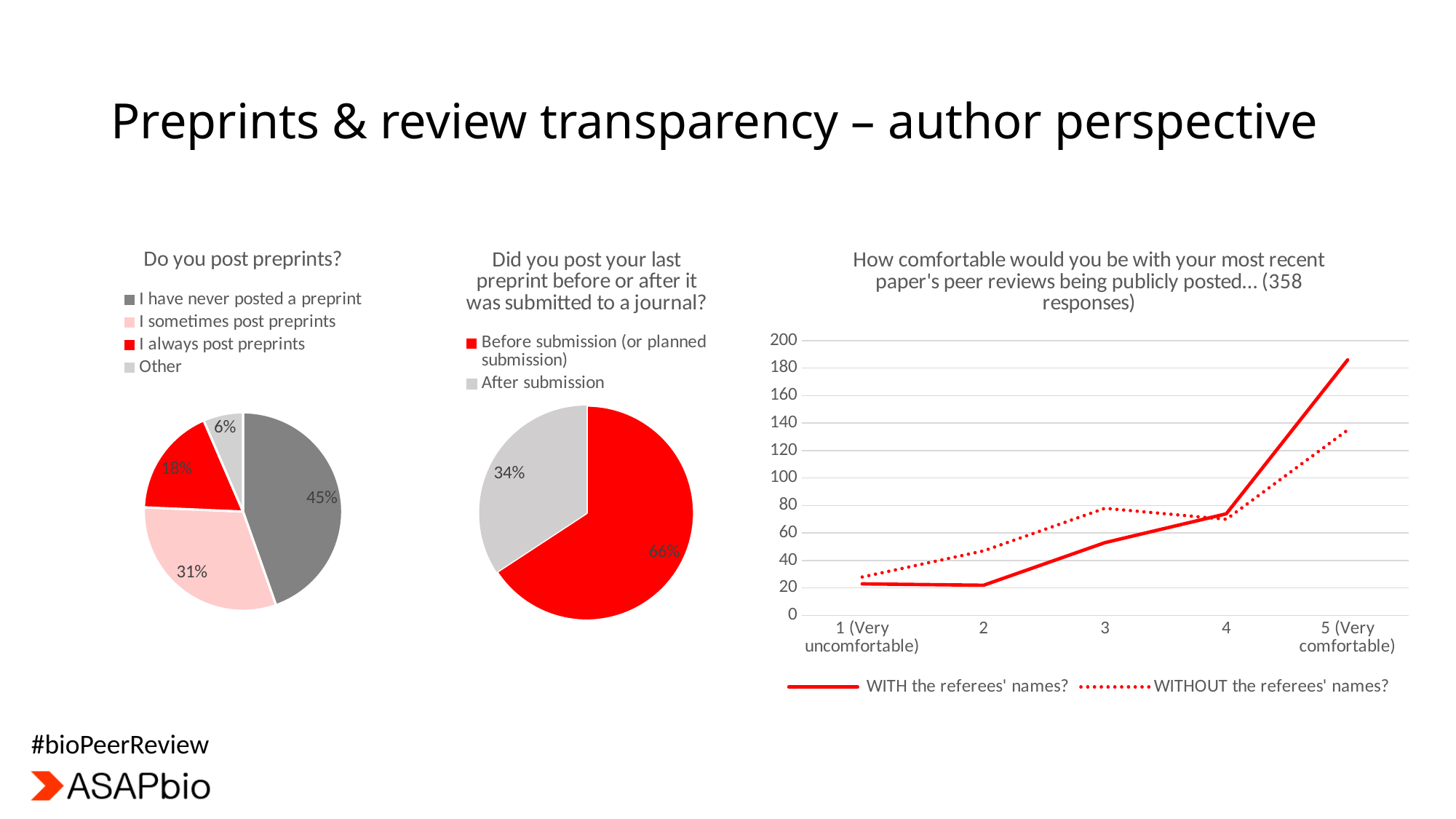
In the 'Do you post preprints?' pie chart, what share is 'I always post preprints'? 18% In the 'Do you post preprints?' pie chart, what percentage of respondents have never posted a preprint? 45% In the middle pie chart about posting the last preprint before or after journal submission, what percentage posted before submission (or planned submission)? 66% In the 'Do you post preprints?' pie chart, which category has the smallest slice? Other In the line chart on the right, does the 'WITH the referees' names?' series generally rise or fall from 1 (Very uncomfortable) to 5 (Very comfortable)? Rise In the line chart on the right, how many series does the legend list? 2 In the line chart on the right, is the value for 'WITH the referees' names?' at '5 (Very comfortable)' greater or less than 160? greater In the middle pie chart, which is larger: 'Before submission (or planned submission)' or 'After submission'? Before submission (or planned submission) In the line chart on the right, is the value for 'WITHOUT the referees' names?' at '1 (Very uncomfortable)' greater or less than 40? less In the middle pie chart, how many categories are shown? 2 In the 'Do you post preprints?' pie chart, what is the difference between 'I sometimes post preprints' and 'I always post preprints'? 13% What kind of chart is the chart on the right about comfort with peer reviews being publicly posted? Line chart